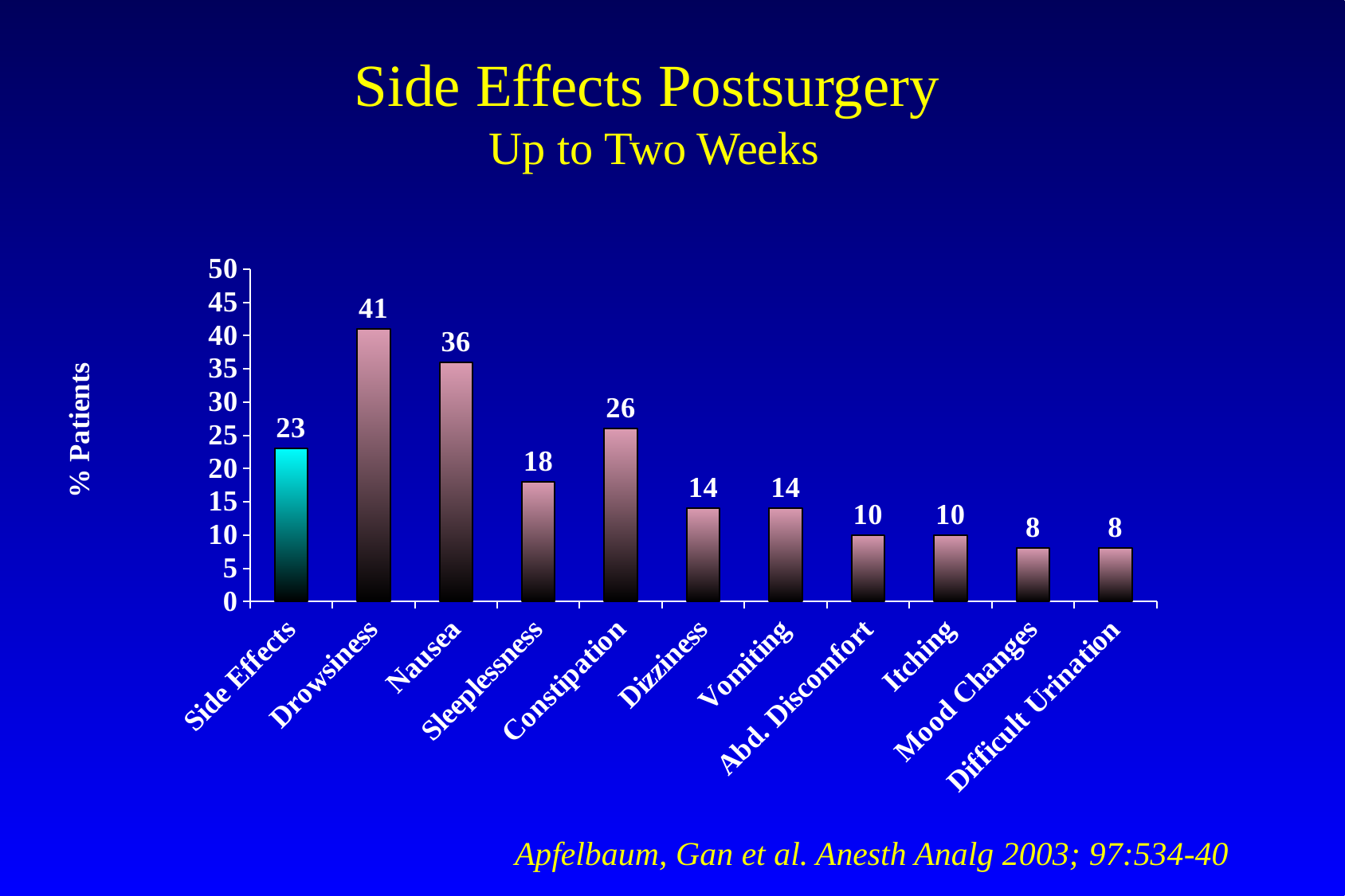
What is the value for Drowsiness? 41 What is the difference between the values for Dizziness and Mood Changes? 6 Which category has the highest value? Drowsiness What is the value for Constipation? 26 How many categories are shown on the x axis? 11 What kind of chart is shown on the slide? bar chart Which bar is coloured differently from the others? Side Effects Is the value for Nausea greater or less than 30? greater What is the difference between the values for Drowsiness and Nausea? 5 What is the label of the y axis? % Patients What is the value for Side Effects? 23 Which is larger, the value for Sleeplessness or the value for Constipation? Constipation